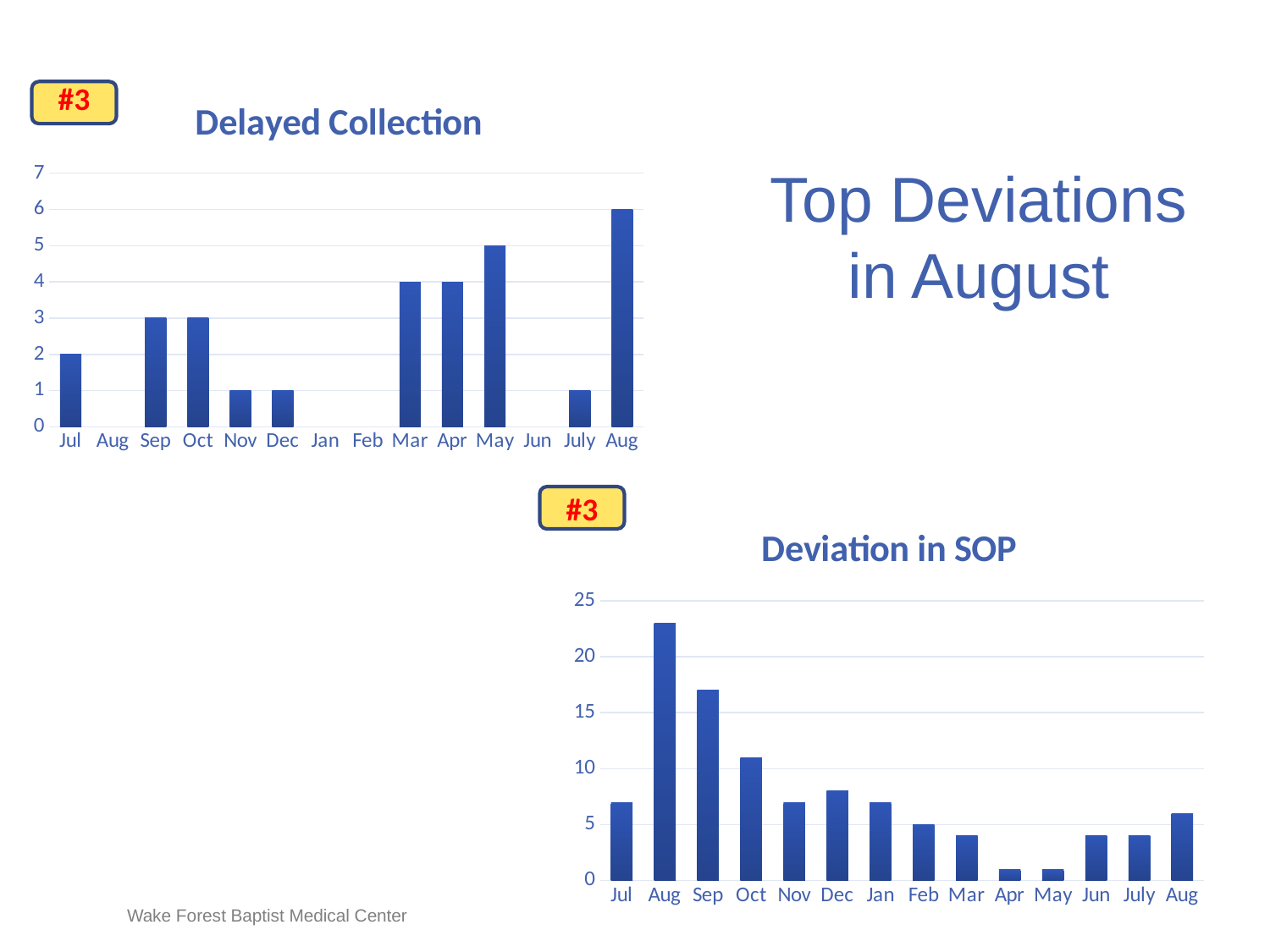
In the Delayed Collection chart, what is the value for May? 5 How many months are shown on the x axis of the Delayed Collection chart? 14 In the Delayed Collection chart, which is larger, the value for Mar or the value for Nov? Mar In the Deviation in SOP chart, is the value for Aug (the second bar) greater or less than 20? greater In the Deviation in SOP chart, which month has the highest value? Aug What kind of chart is the Deviation in SOP chart? Bar chart In the Deviation in SOP chart, is the value for Apr greater or less than 5? less In the Delayed Collection chart, what is the difference between the values for May and Jul? 3 In the Delayed Collection chart, what is the value for Aug at the far right of the x axis? 6 In the Delayed Collection chart, which month has the highest value? Aug What is the title of the chart in the bottom right of the slide? Deviation in SOP In the Deviation in SOP chart, which is larger, the value for Sep or the value for Oct? Sep